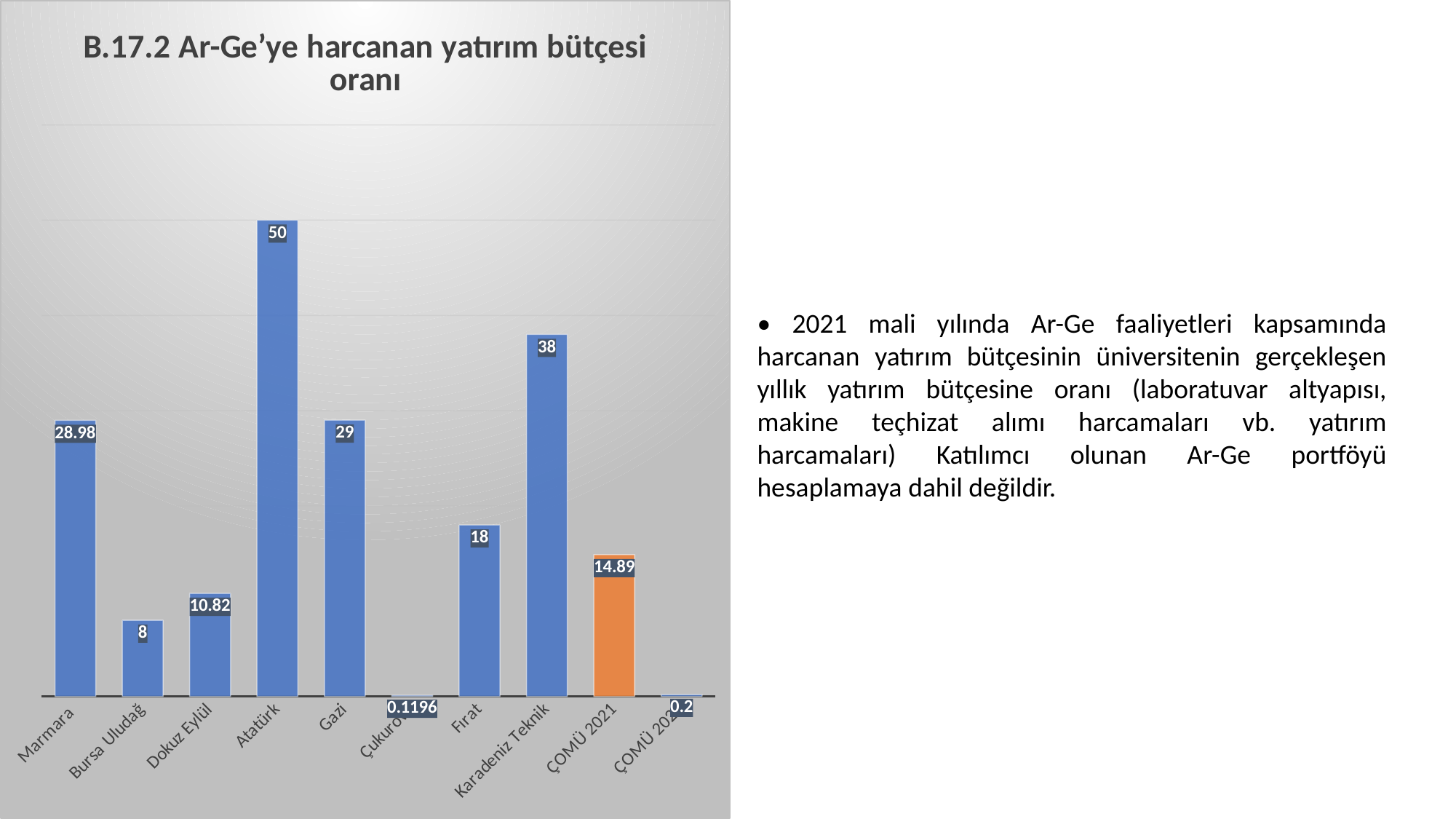
What is the value for Karadeniz Teknik? 38 What is the difference between the values for Gazi and Bursa Uludağ? 21 How many bars are shown in the chart? 10 What is the value for ÇOMÜ 2021? 14.89 Which category has the highest value? Atatürk What kind of chart is shown on the slide? Bar chart What is the difference between the values for Atatürk and Karadeniz Teknik? 12 Which is larger, the value for Fırat or the value for ÇOMÜ 2021? Fırat What is the value for Atatürk? 50 What is the title of the chart? B.17.2 Ar-Ge'ye harcanan yatırım bütçesi oranı What is the value for Marmara? 28.98 What is the value for Dokuz Eylül? 10.82